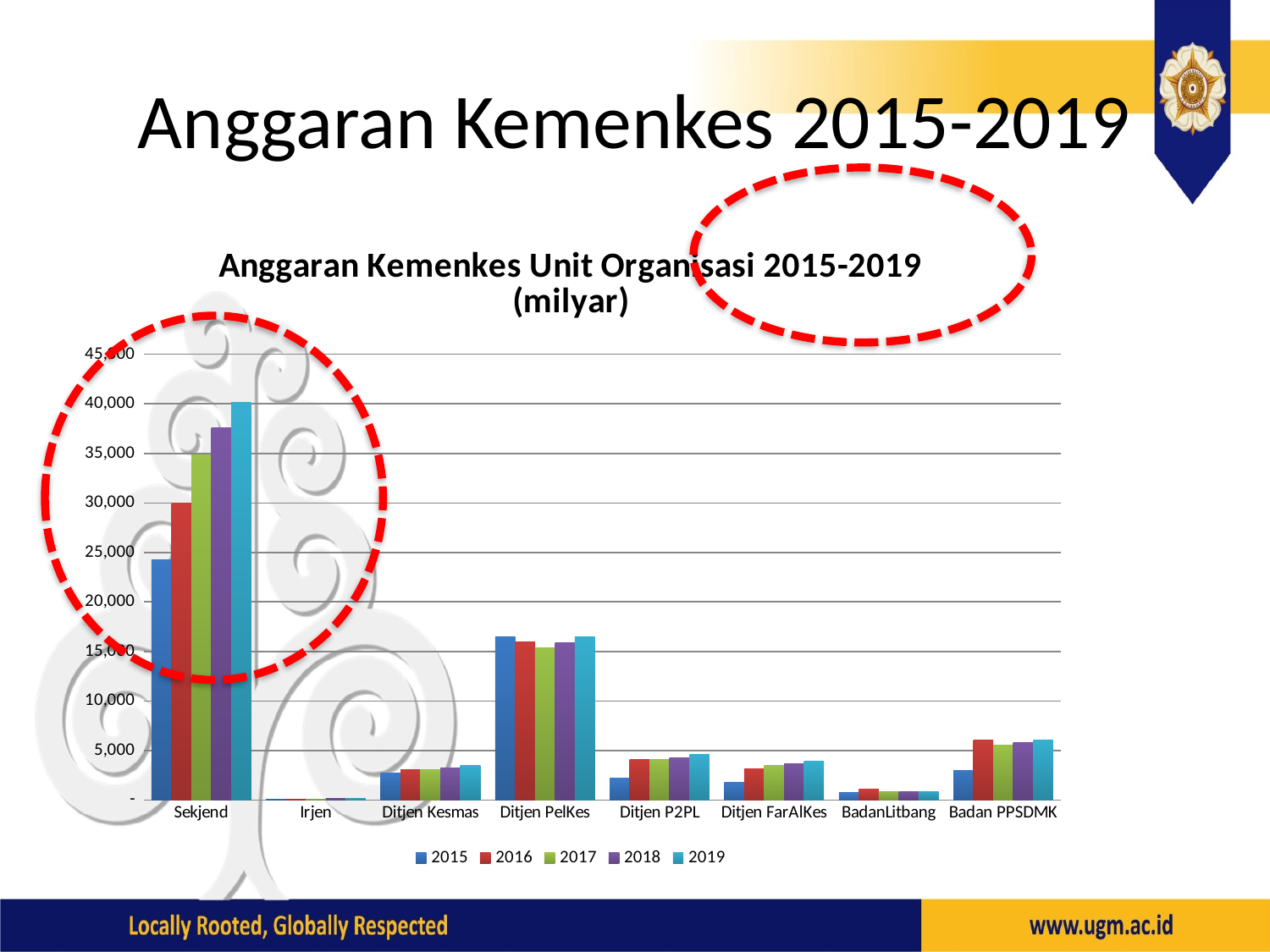
Is the 2015 value for Ditjen PelKes greater or less than 15,000? greater Which is larger in 2019: the value for Sekjend or the value for Ditjen PelKes? Sekjend How many organisational units (categories) are shown on the x axis of the chart? 8 Is the 2015 value for Sekjend greater or less than 20,000? greater Which organisational unit has the lowest budget bars in the chart? Irjen Is the 2019 value for Ditjen P2PL greater or less than 5,000? less Which is larger in 2015: the value for Badan PPSDMK or the value for BadanLitbang? Badan PPSDMK Which organisational unit has the highest budget bars in the chart? Sekjend How many series does the chart legend list? 5 What kind of chart is shown on the slide? bar chart What is the title of the chart? Anggaran Kemenkes Unit Organisasi 2015-2019 (milyar) Do the Sekjend bars rise or fall from 2015 to 2019? rise